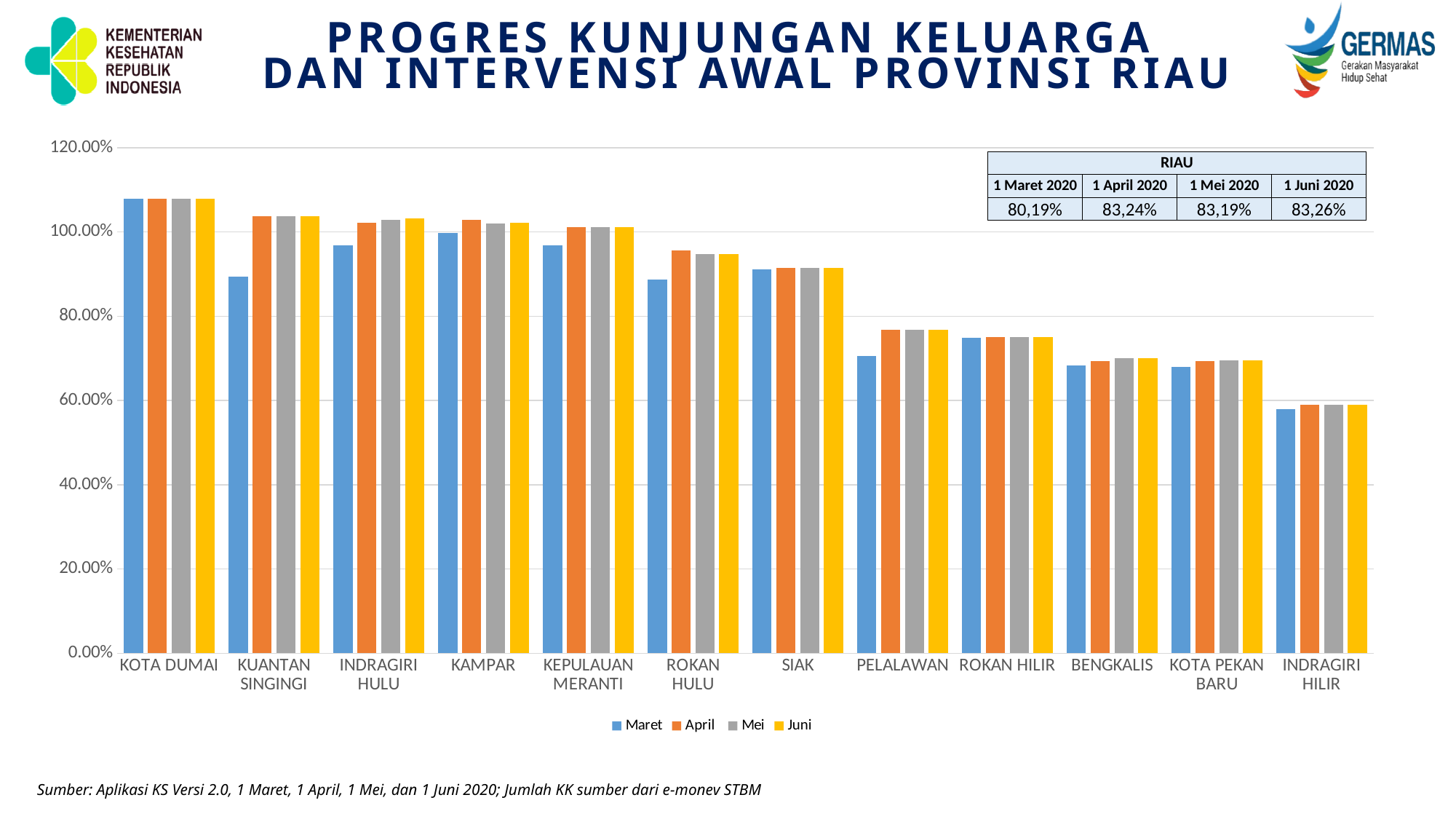
Is the Juni value for KOTA DUMAI greater or less than 100.00%? greater Is the Maret value for INDRAGIRI HILIR greater or less than 60.00%? less Do the values generally rise or fall moving from left to right along the x axis? fall According to the RIAU table on the slide, what is the value for 1 Juni 2020? 83,26% Which category has the highest values in the chart? KOTA DUMAI How many kabupaten/kota categories are shown on the x axis of the chart? 12 Which category has the lowest values in the chart? INDRAGIRI HILIR What kind of chart is shown on the slide? bar chart According to the RIAU table on the slide, what is the value for 1 Maret 2020? 80,19% Is the Maret value for KUANTAN SINGINGI greater or less than 100.00%? less Which is larger: the Juni value for PELALAWAN or the Juni value for BENGKALIS? PELALAWAN How many series does the chart legend list? 4